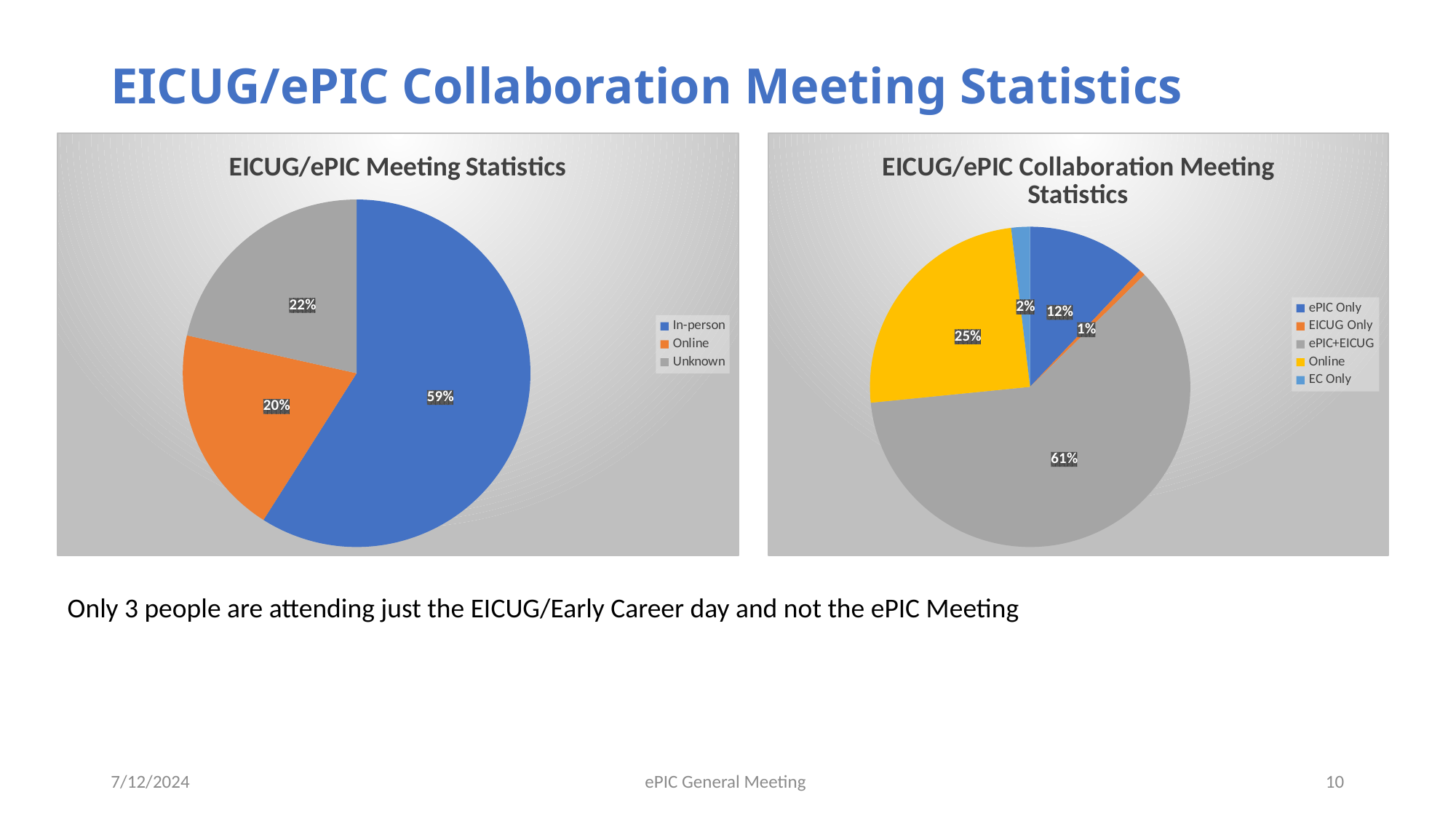
In the right chart titled 'EICUG/ePIC Collaboration Meeting Statistics', what share of the pie is Online? 25% In the right chart titled 'EICUG/ePIC Collaboration Meeting Statistics', what is the difference in percentage points between the ePIC+EICUG slice and the Online slice? 36 In the left chart titled 'EICUG/ePIC Meeting Statistics', what share of the pie is Online? 20% In the right chart titled 'EICUG/ePIC Collaboration Meeting Statistics', what share of the pie is ePIC Only? 12% In the left chart titled 'EICUG/ePIC Meeting Statistics', which category has the largest slice? In-person What kind of chart is the left chart titled 'EICUG/ePIC Meeting Statistics'? Pie chart In the right chart titled 'EICUG/ePIC Collaboration Meeting Statistics', how many categories does the legend list? 5 In the left chart titled 'EICUG/ePIC Meeting Statistics', how many categories does the legend list? 3 In the right chart titled 'EICUG/ePIC Collaboration Meeting Statistics', which category has the smallest slice? EICUG Only